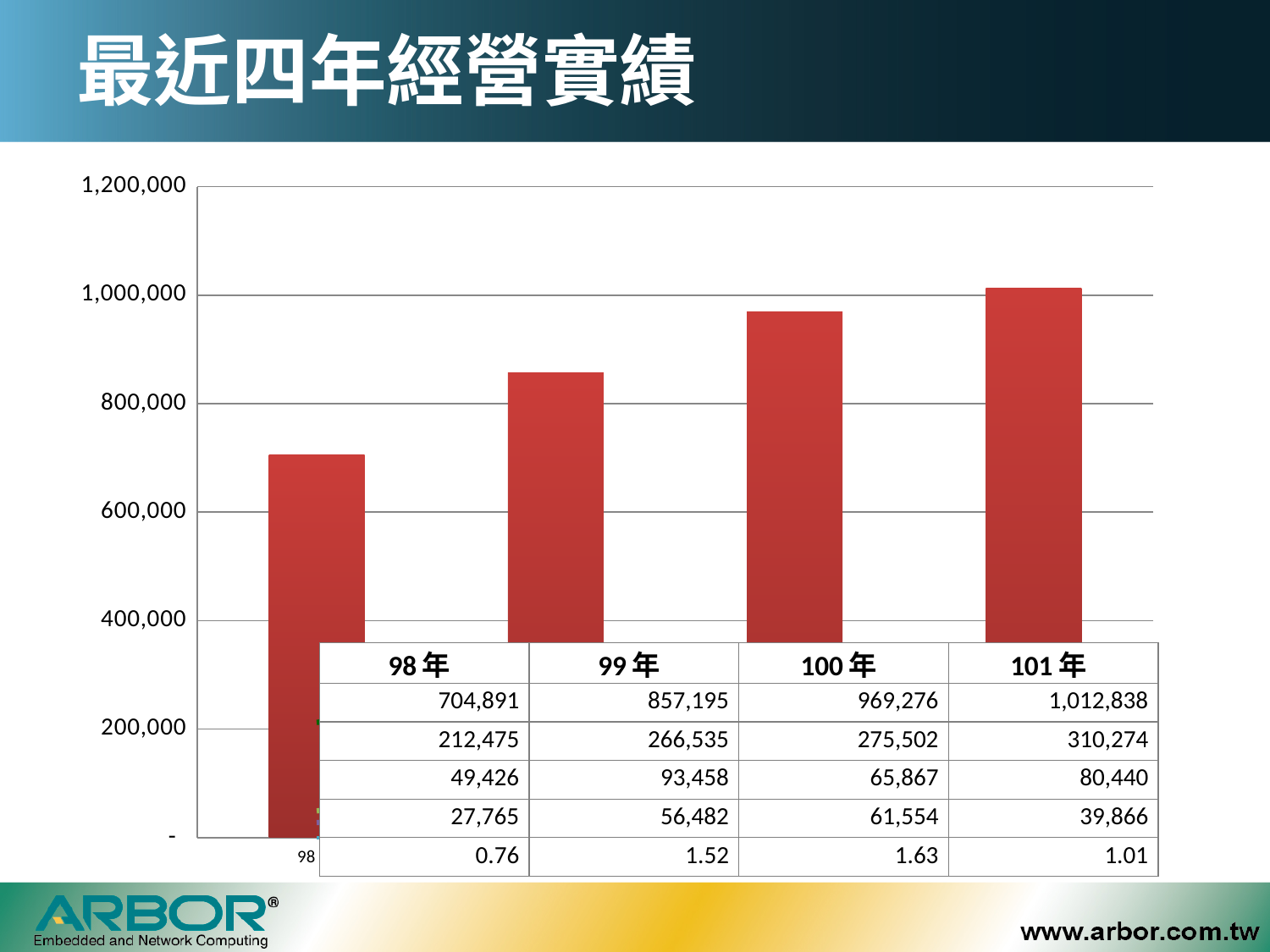
Is the bar value for 101年 greater or less than 1,000,000? greater What is the difference between the bar values for 101年 and 98年? 307,947 What kind of chart is shown on the slide? bar chart What is the value of the bar for 98年? 704,891 Which bar is taller, 100年 or 99年? 100年 What is the value of the bar for 99年? 857,195 How many bars are shown in the chart? 4 Which year has the shortest bar? 98年 Which year has the tallest bar? 101年 What is the value of the bar for 101年? 1,012,838 What is the difference between the bar values for 99年 and 98年? 152,304 Do the bar values rise or fall from 98年 to 101年? rise